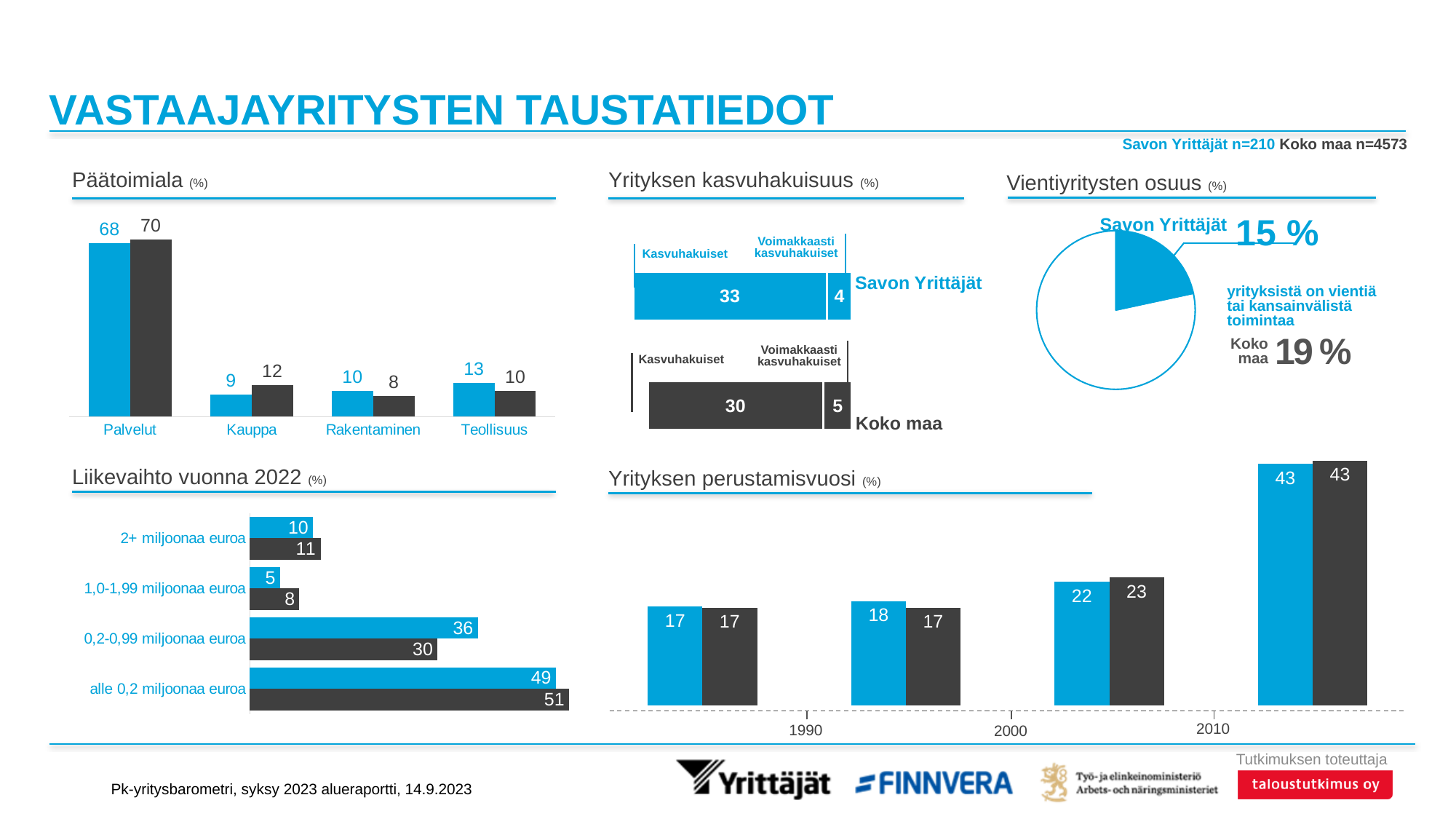
In the 'Päätoimiala' chart, how many categories are shown on the x axis? 4 In the 'Yrityksen perustamisvuosi' chart, do the Savon Yrittäjät values rise or fall from left to right along the x axis? rise In the 'Päätoimiala' chart, what is the difference between the Koko maa value for Kauppa and the Savon Yrittäjät value for Kauppa? 3 In the 'Yrityksen kasvuhakuisuus' chart, what is the total of the Savon Yrittäjät stacked bar (Kasvuhakuiset plus Voimakkaasti kasvuhakuiset)? 37 In the 'Yrityksen perustamisvuosi' chart, what is the difference between the Koko maa value and the Savon Yrittäjät value in the third group (around 2000-2010)? 1 In the 'Liikevaihto vuonna 2022' chart, what is the Koko maa value for 'alle 0,2 miljoonaa euroa'? 51 In the 'Yrityksen kasvuhakuisuus' chart, what is the Voimakkaasti kasvuhakuiset value for Koko maa? 5 In the 'Liikevaihto vuonna 2022' chart, which is larger for '0,2-0,99 miljoonaa euroa': the Savon Yrittäjät value or the Koko maa value? Savon Yrittäjät In the 'Vientiyritysten osuus' chart, what kind of chart is used? pie chart In the 'Päätoimiala' chart, which category has the highest value for Koko maa? Palvelut In the 'Vientiyritysten osuus' chart, what share of Savon Yrittäjät companies have export or international activity? 15 % In the 'Päätoimiala' chart, what is the Savon Yrittäjät value for Palvelut? 68